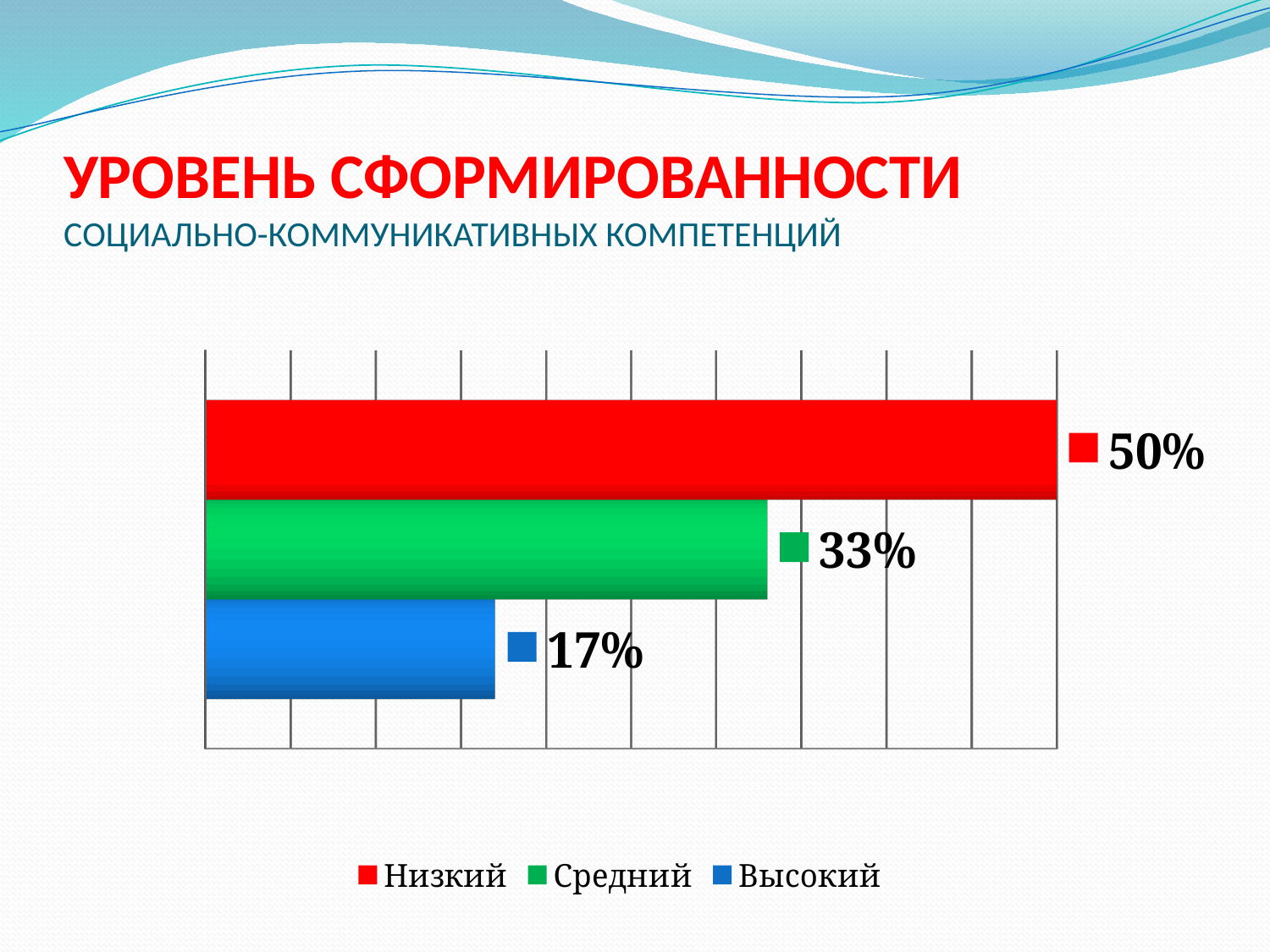
Which level has the lowest value? Высокий How many series does the legend list? 3 What is the difference between the values for Низкий and Средний? 17% What colour is the bar for Высокий? Blue What kind of chart is shown on the slide? Bar chart What is the value for Высокий? 17% What is the difference between the values for Средний and Высокий? 16% Which level has the highest value? Низкий Which is larger, the value for Средний or the value for Высокий? Средний What is the value for Средний? 33% What is the value for Низкий? 50% What is the total of the three values shown? 100%